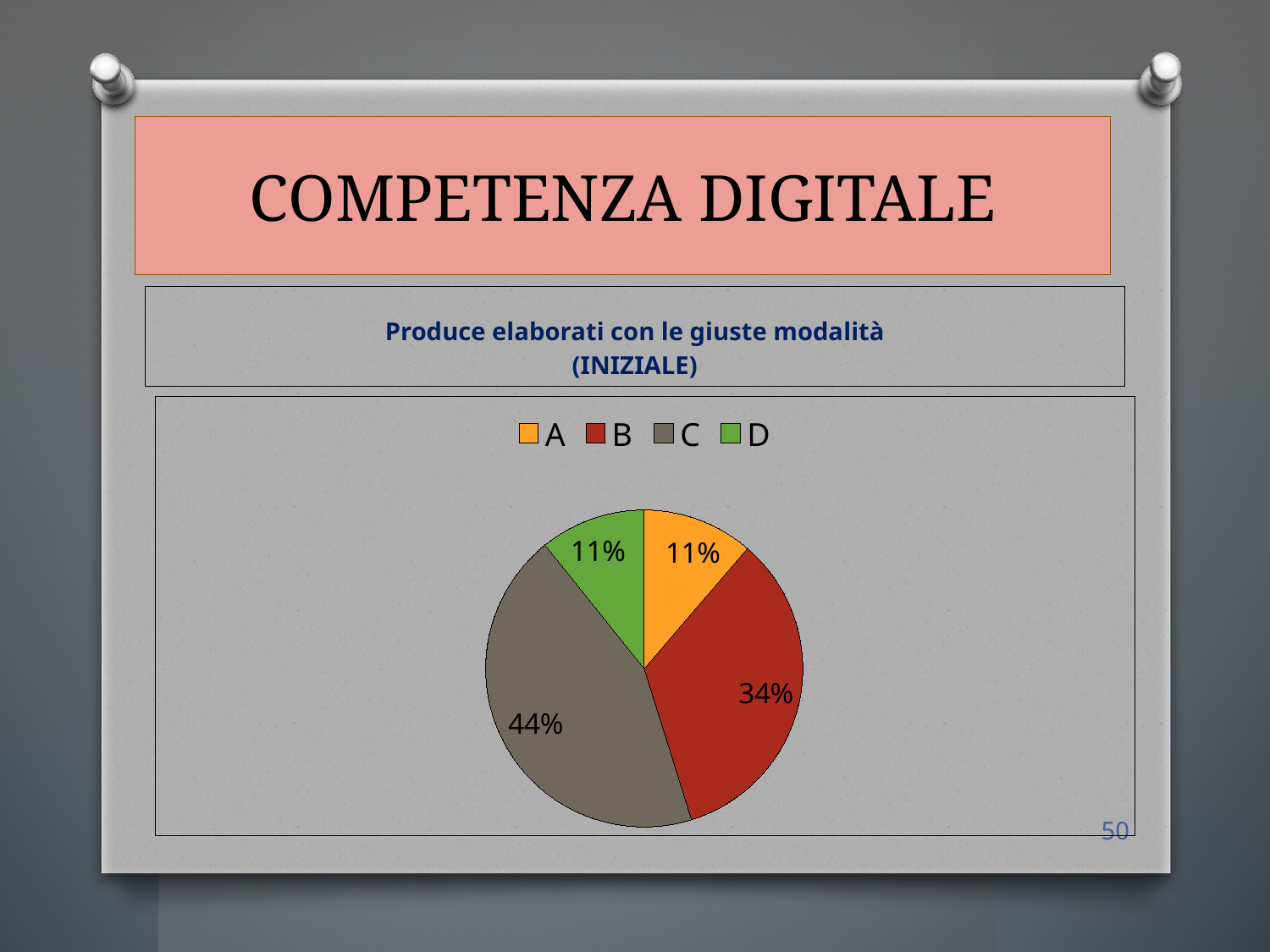
What percentage does slice C represent? 44% What is the combined share of A and D? 22% How many categories does the legend list? 4 What percentage does slice B represent? 34% What type of chart is shown on the slide? pie chart What percentage does slice A represent? 11% Which is larger, the share for B or the share for D? B What is the text in the box above the chart? Produce elaborati con le giuste modalità (INIZIALE) What colour is the slice for category C? grey What is the difference in percentage points between C and B? 10 What percentage does slice D represent? 11% Which category has the largest share of the pie? C